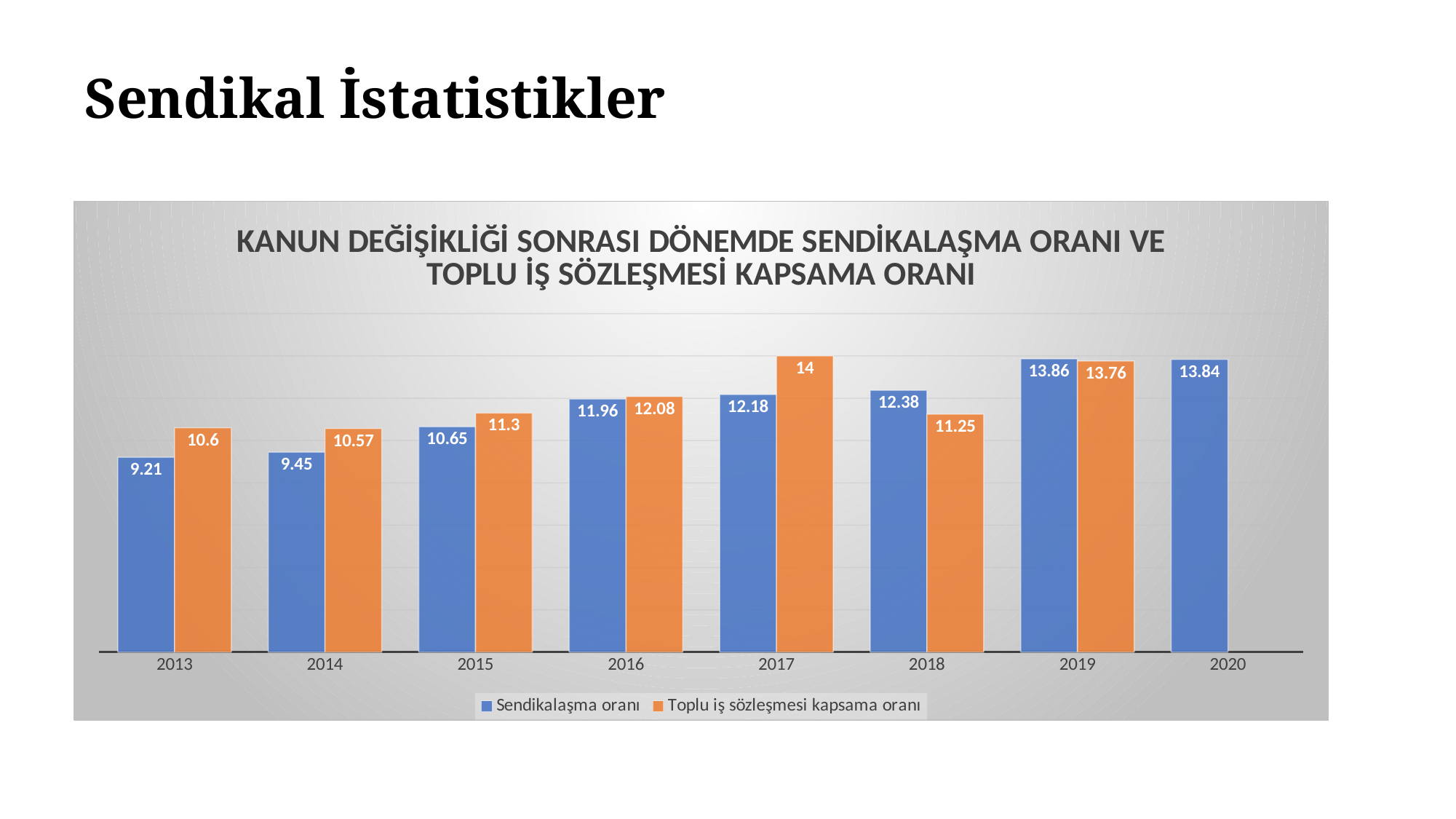
Does the Sendikalaşma oranı rise or fall from 2013 to 2019? Rise In which year is the Toplu iş sözleşmesi kapsama oranı highest? 2017 How many years are shown on the x axis of the chart? 8 How many series does the chart legend list? 2 What is the Sendikalaşma oranı value for 2013? 9.21 What is the Toplu iş sözleşmesi kapsama oranı value for 2017? 14 What is the Toplu iş sözleşmesi kapsama oranı value for 2015? 11.3 What is the Sendikalaşma oranı value for 2020? 13.84 What kind of chart is shown on the slide? Bar chart In 2018, which is larger: the Sendikalaşma oranı or the Toplu iş sözleşmesi kapsama oranı? Sendikalaşma oranı What is the difference between the Toplu iş sözleşmesi kapsama oranı and the Sendikalaşma oranı in 2017? 1.82 In which year is the Sendikalaşma oranı lowest? 2013